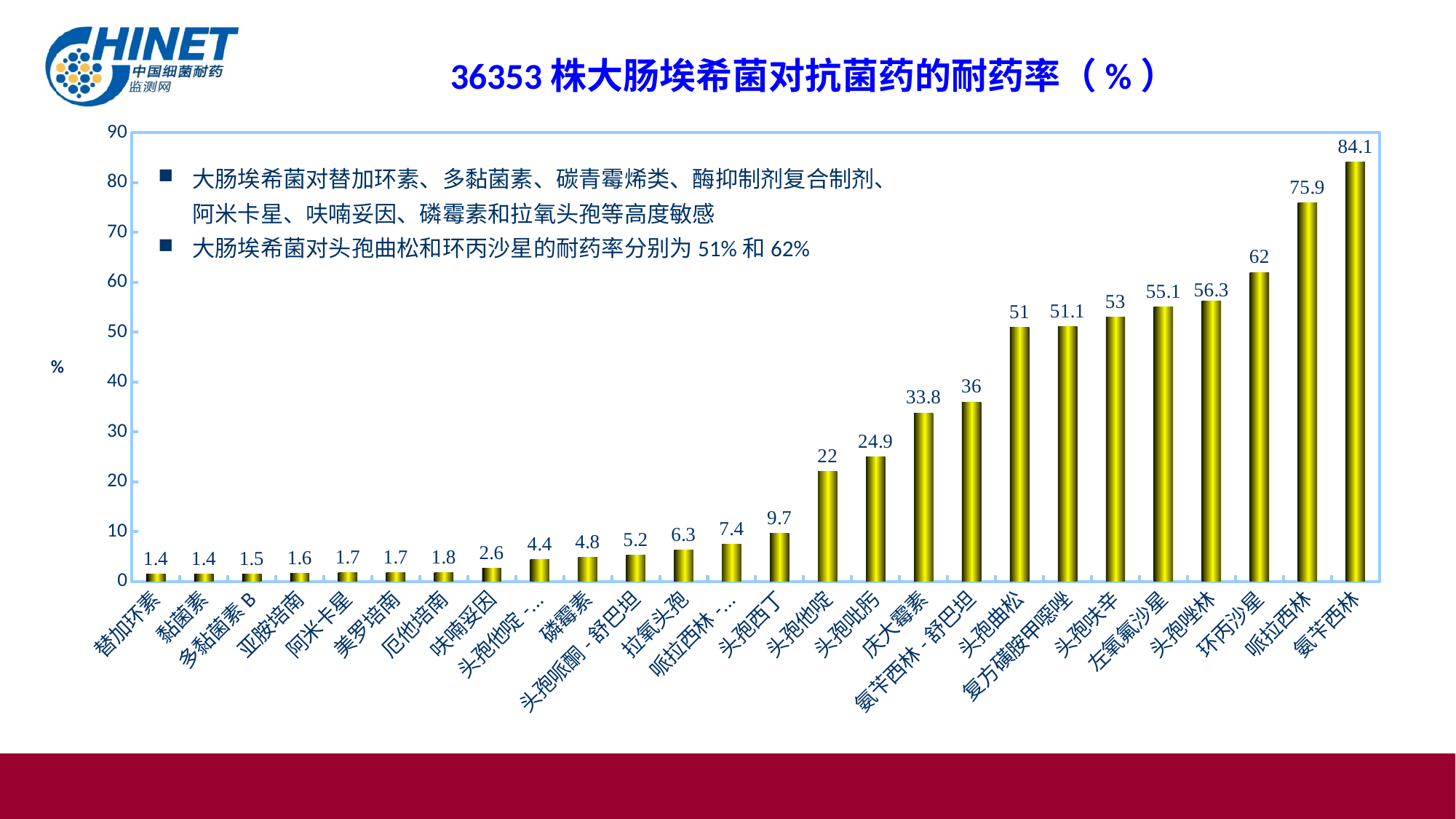
What kind of chart is shown on the slide? bar chart Which has a higher resistance rate, 头孢吡肟 or 头孢他啶? 头孢吡肟 What is the difference between the resistance rates for 氨苄西林 and 哌拉西林? 8.2 Which antibiotic has the highest resistance rate? 氨苄西林 Do the values rise or fall from left to right along the x axis? rise What is the difference between the resistance rates for 环丙沙星 and 头孢曲松? 11 What is the resistance rate for 庆大霉素? 33.8 Which has a higher resistance rate, 左氧氟沙星 or 头孢呋辛? 左氧氟沙星 What is the resistance rate for 氨苄西林? 84.1 How many antibiotics are shown on the x axis? 26 What is the resistance rate for 头孢曲松? 51 What is the resistance rate for 呋喃妥因? 2.6